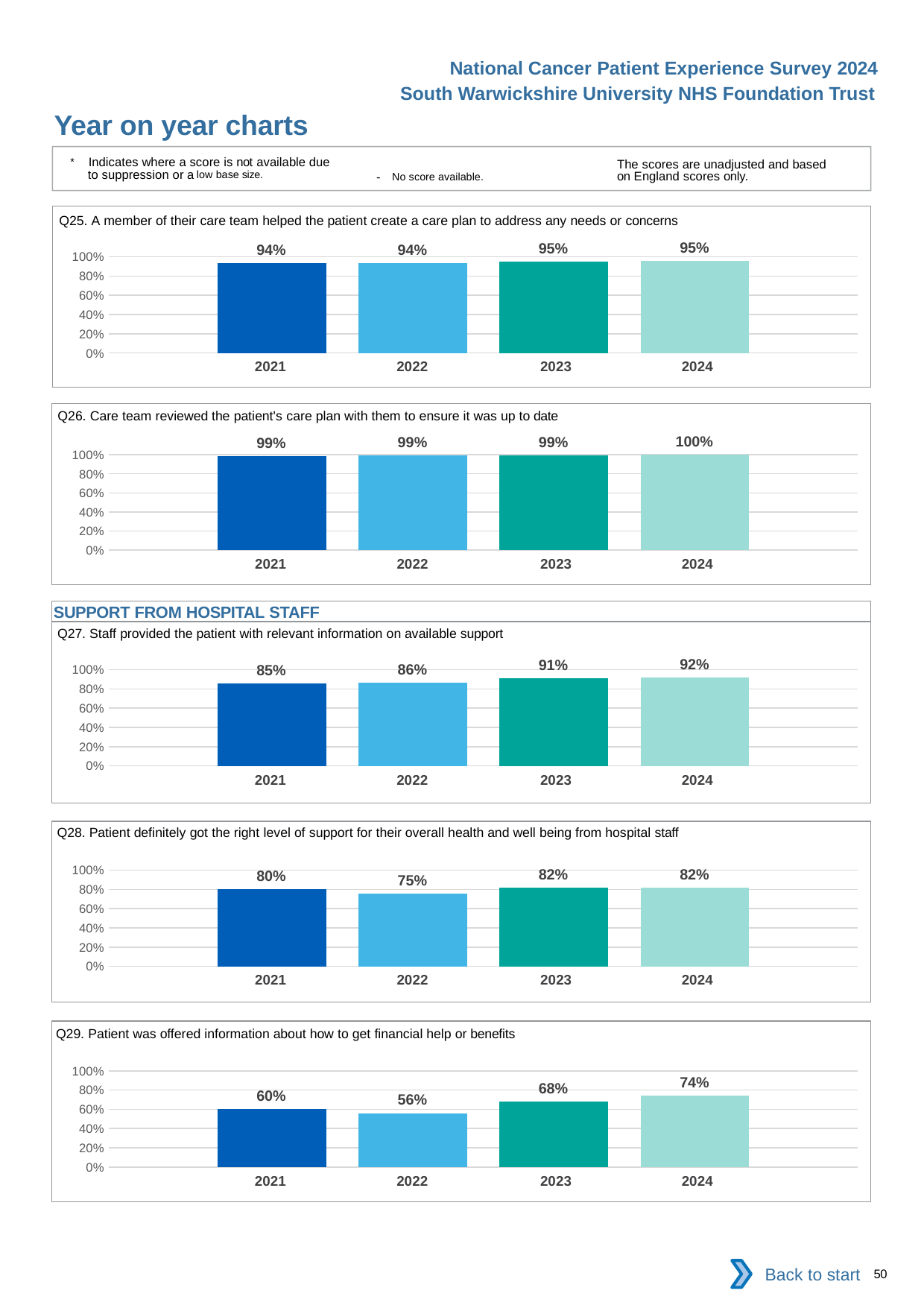
In the Q29 chart, what is the value for 2022? 56% In the Q29 chart, is the value for 2021 larger or the value for 2023? 2023 In the Q28 chart, what is the difference between the 2021 and 2022 values? 5% In the Q26 chart, which year has the highest value? 2024 In the Q29 chart, is the value for 2024 greater or less than 60%? greater In the Q25 chart, what is the value for 2023? 95% In the Q27 chart, what is the difference between the 2024 and 2021 values? 7% In the Q27 chart, do the values rise or fall from 2021 to 2024? rise How many bars are in the Q28 chart? 4 What is the section heading shown above the Q27 chart? SUPPORT FROM HOSPITAL STAFF In the Q28 chart, which year has the lowest value? 2022 What kind of chart is the Q27 chart? bar chart